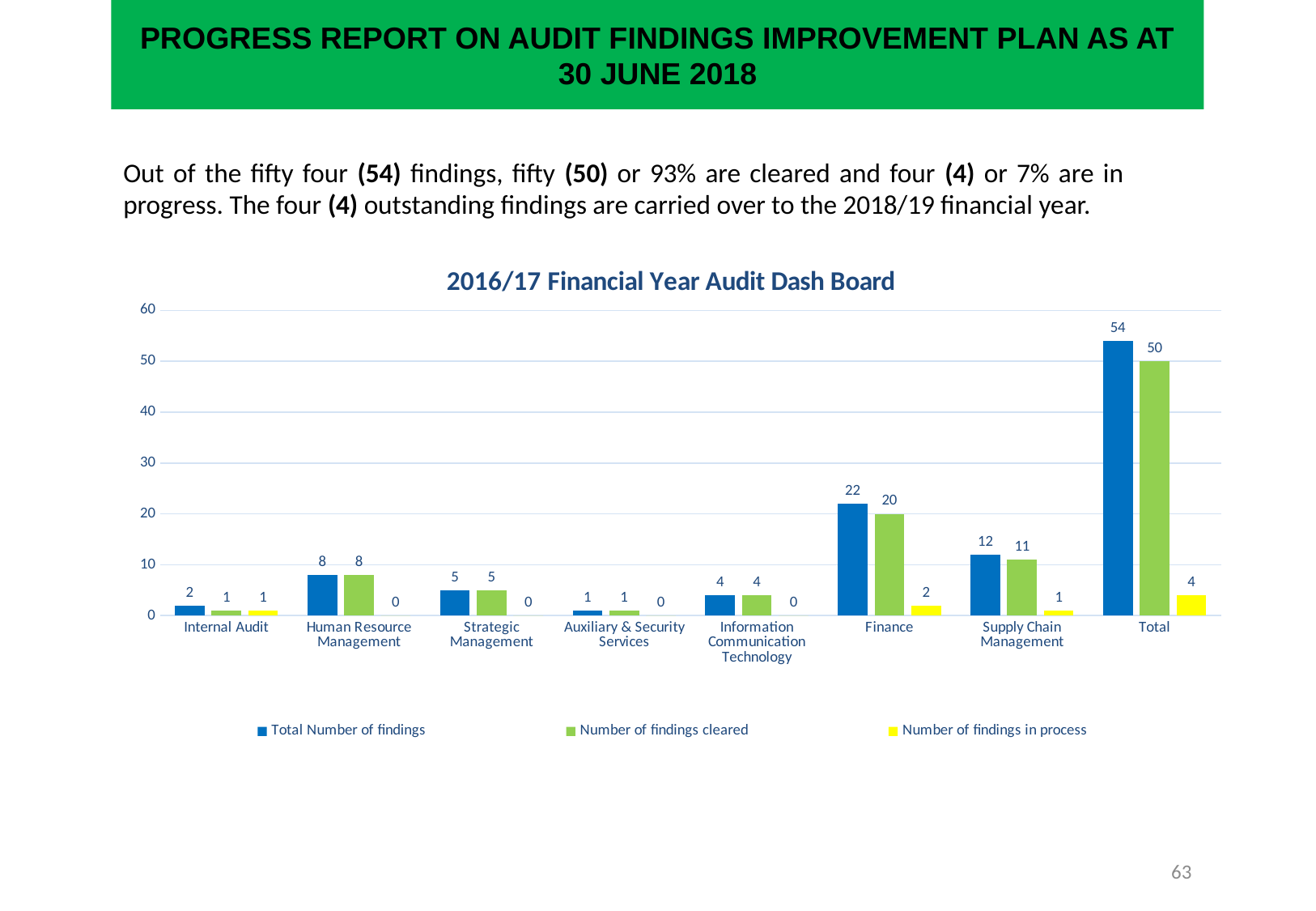
What is the difference between the Total Number of findings and the Number of findings cleared for Finance? 2 How many categories are shown on the x axis? 8 What is the Number of findings cleared for Supply Chain Management? 11 What is the Number of findings in process for Internal Audit? 1 Excluding the Total category, which department has the highest Total Number of findings? Finance What is the title of the chart? 2016/17 Financial Year Audit Dash Board What is the Number of findings cleared for the Total category? 50 What is the Total Number of findings for Finance? 22 Which is larger: the Total Number of findings for Human Resource Management or for Strategic Management? Human Resource Management Which category has the lowest Total Number of findings? Auxiliary & Security Services What type of chart is shown on the slide? bar chart How many series does the legend list? 3